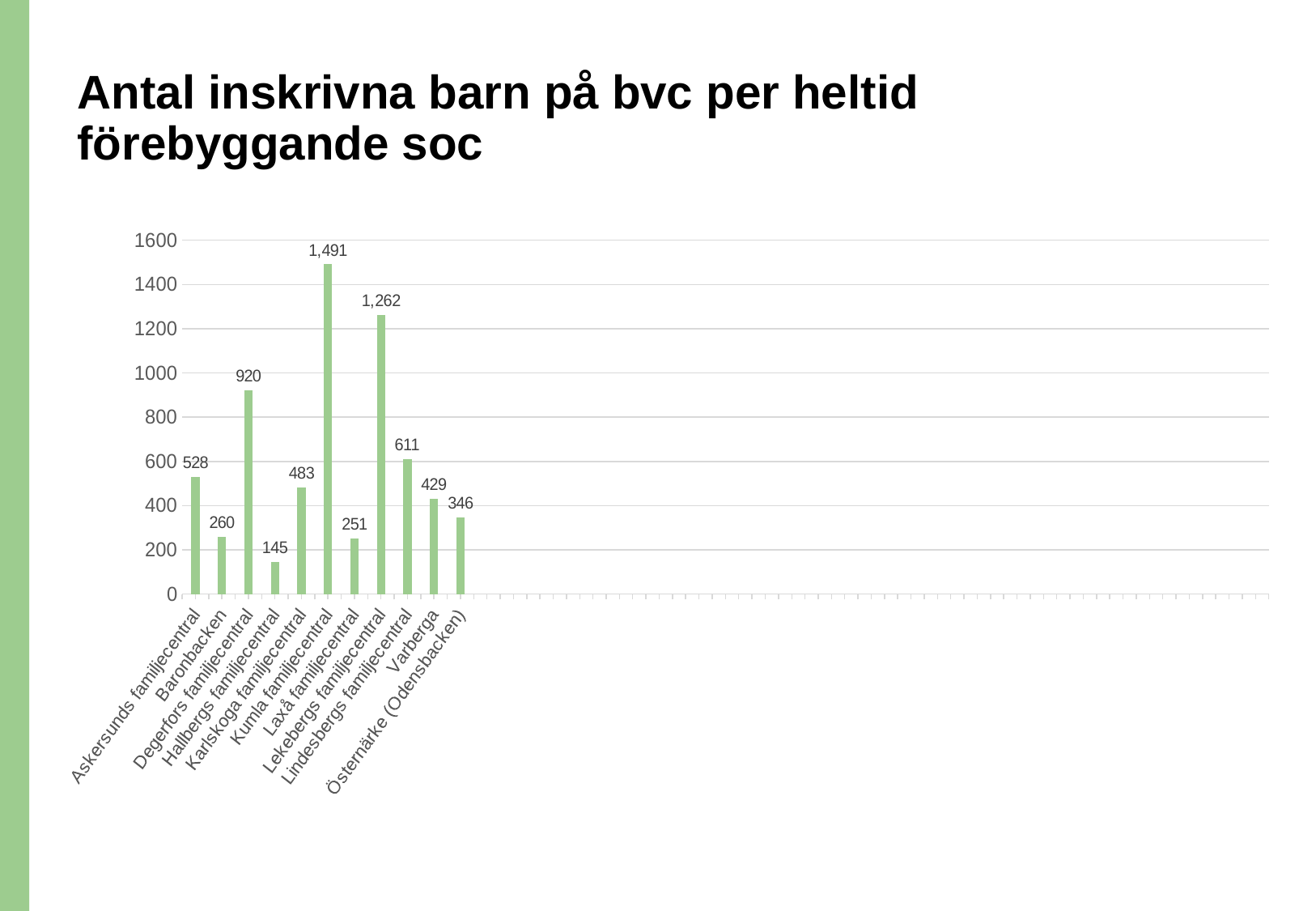
Is the value for Degerfors familjecentral greater or less than 800? greater What is the value for Lindesbergs familjecentral? 611 What is the value for Kumla familjecentral? 1,491 What is the difference between the values for Kumla familjecentral and Lekebergs familjecentral? 229 Which category has the lowest value? Hallbergs familjecentral How many categories are shown on the x axis? 11 Which category has the highest value? Kumla familjecentral What is the title of the slide? Antal inskrivna barn på bvc per heltid förebyggande soc What is the value for Baronbacken? 260 What is the value for Östernärke (Odensbacken)? 346 What kind of chart is shown on the slide? Bar chart Which is larger, the value for Askersunds familjecentral or the value for Karlskoga familjecentral? Askersunds familjecentral